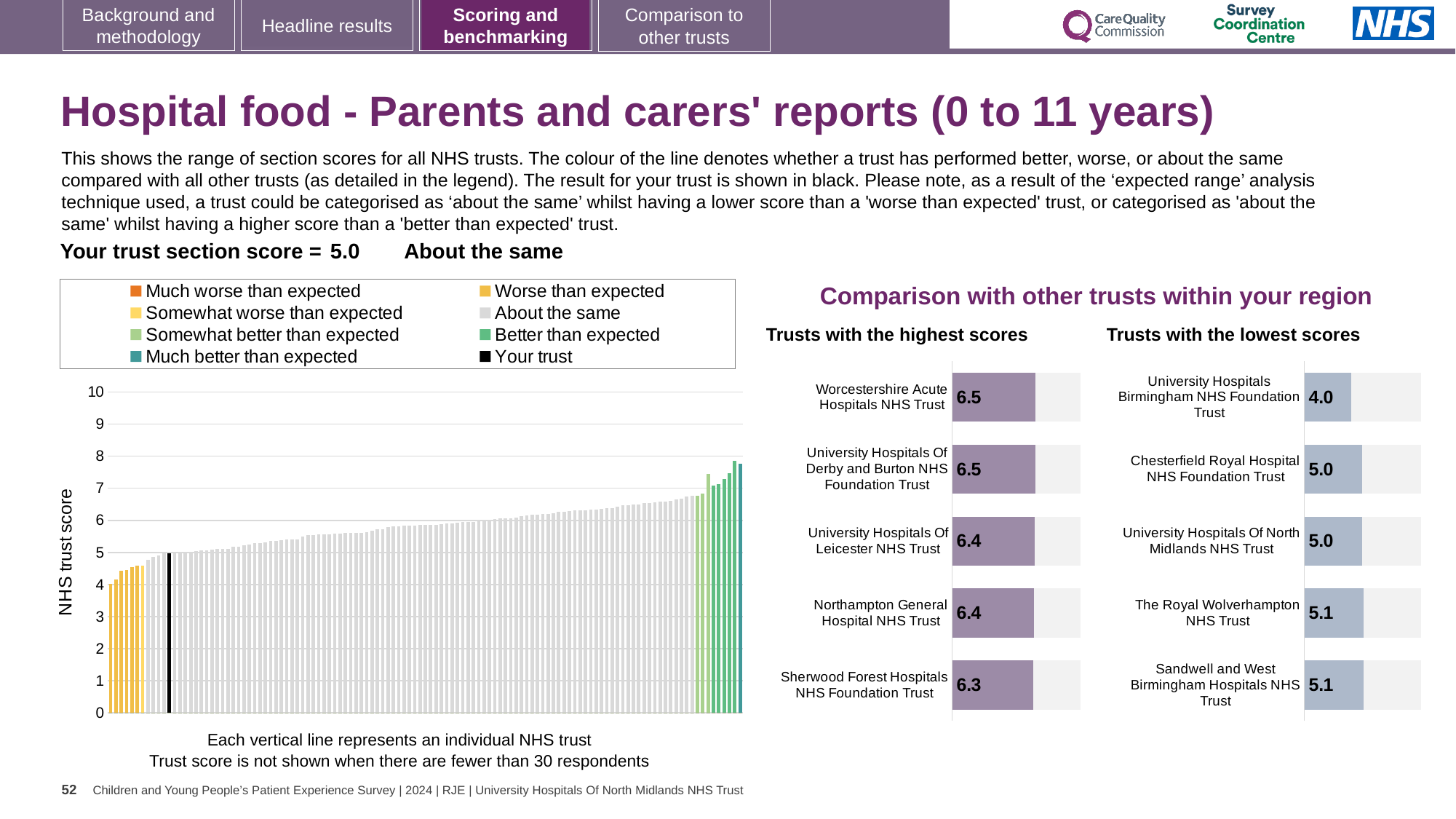
In the 'Trusts with the lowest scores' chart, what is the difference between the scores of Sandwell and West Birmingham Hospitals NHS Trust and University Hospitals Birmingham NHS Foundation Trust? 1.1 In the 'Trusts with the lowest scores' chart, what is the score for University Hospitals Birmingham NHS Foundation Trust? 4.0 How many trusts are listed in the 'Trusts with the highest scores' chart? 5 In the 'Trusts with the highest scores' chart, what is the score for Worcestershire Acute Hospitals NHS Trust? 6.5 In the main 'NHS trust score' chart, is the value of the tallest bar greater or less than 7? greater In the main 'NHS trust score' chart, do the bar values rise or fall from left to right? rise How many entries does the legend of the main 'NHS trust score' chart list? 8 What kind of chart is the main 'NHS trust score' chart? bar chart In the 'Trusts with the highest scores' chart, what is the score for Sherwood Forest Hospitals NHS Foundation Trust? 6.3 In the 'Trusts with the lowest scores' chart, which has the higher score: The Royal Wolverhampton NHS Trust or University Hospitals Birmingham NHS Foundation Trust? The Royal Wolverhampton NHS Trust In the 'Trusts with the lowest scores' chart, which trust has the lowest score? University Hospitals Birmingham NHS Foundation Trust In the 'Trusts with the highest scores' chart, what is the difference between the scores of Worcestershire Acute Hospitals NHS Trust and Sherwood Forest Hospitals NHS Foundation Trust? 0.2